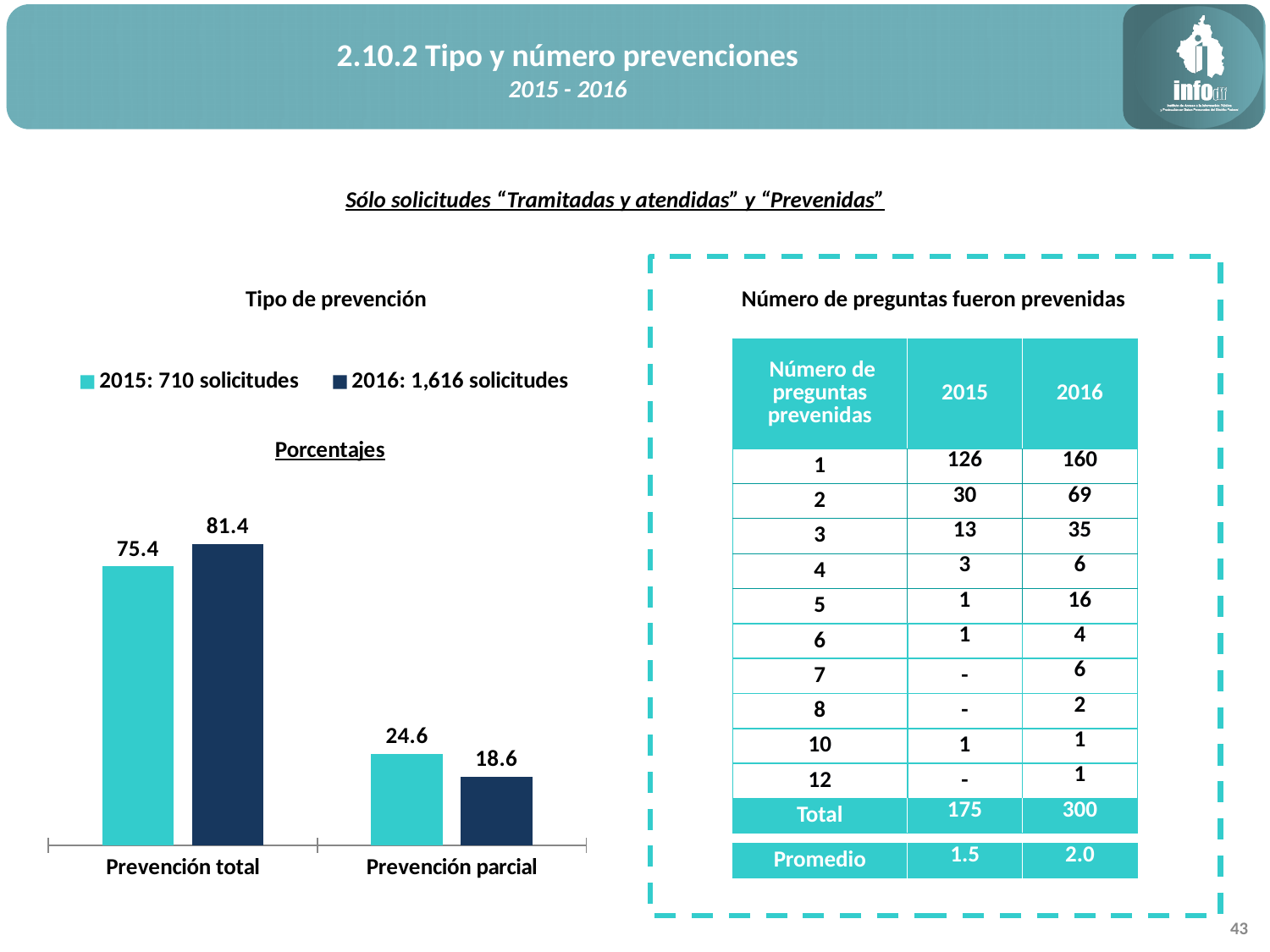
What is the difference between the 2015 and 2016 values for Prevención parcial? 6.0 What is the value for Prevención parcial in the 2016 series? 18.6 Which category has the lowest value in the 2015 series? Prevención parcial How many categories are shown on the x axis of the chart? 2 What type of chart is shown on the slide? Bar chart For Prevención parcial, which series has the larger value, 2015 or 2016? 2015 How many series does the chart legend list? 2 What is the value for Prevención parcial in the 2015 series? 24.6 What is the value for Prevención total in the 2016 series? 81.4 Which category has the highest value in the 2016 series? Prevención total What is the difference between the 2016 and 2015 values for Prevención total? 6.0 What is the value for Prevención total in the 2015 series? 75.4